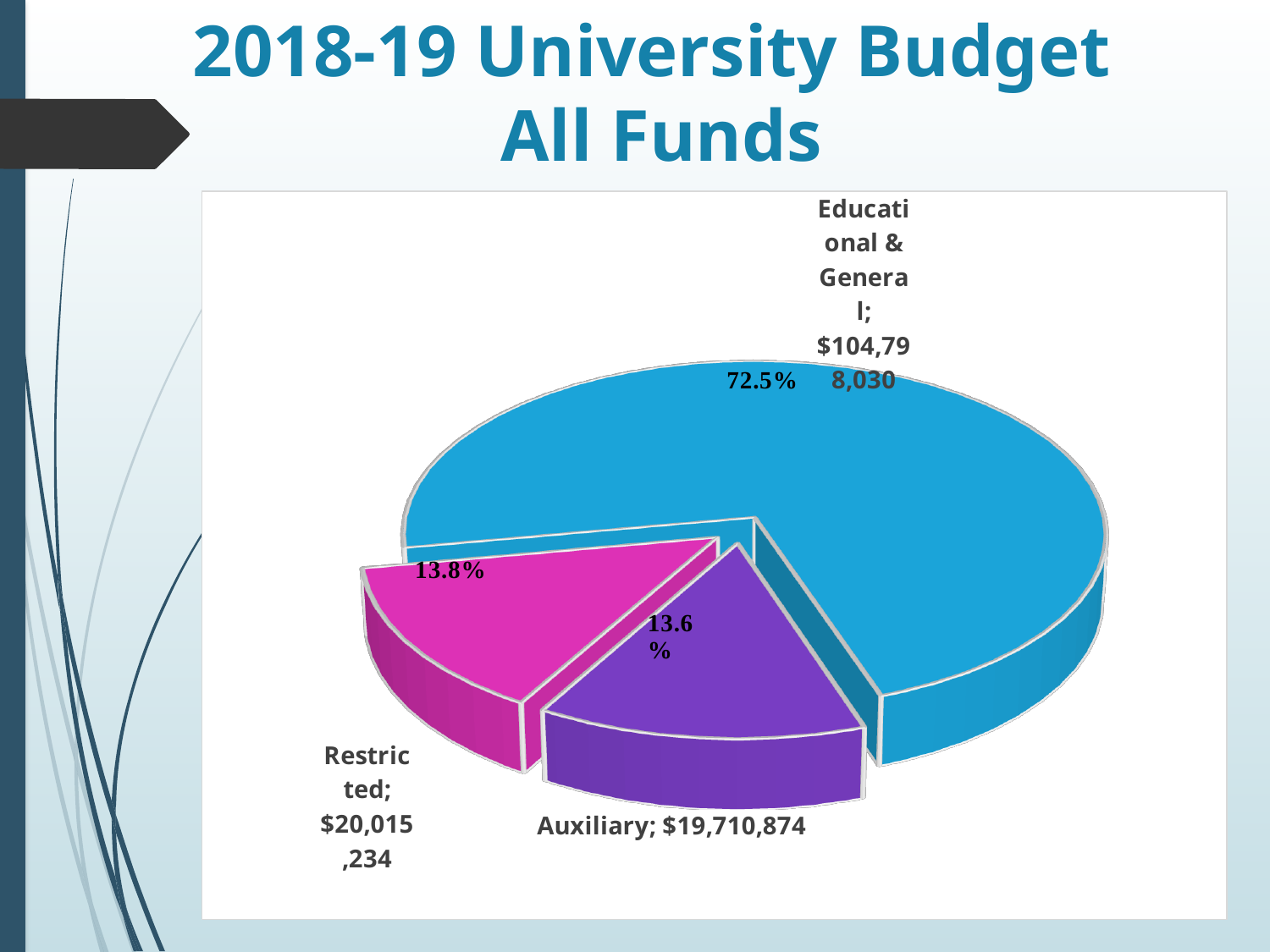
What is the value for Educational & General? $104,798,030 What is the value for Restricted? $20,015,234 How many slices does the pie chart have? 3 Which is larger, Restricted or Auxiliary? Restricted Which category has the largest slice? Educational & General What percentage share does Restricted have? 13.8% What is the value for Auxiliary? $19,710,874 What kind of chart is shown on the slide? Pie chart What percentage share does Auxiliary have? 13.6% Which category has the smallest slice? Auxiliary What is the difference between the Restricted and Auxiliary values? $304,360 What percentage share does Educational & General have? 72.5%